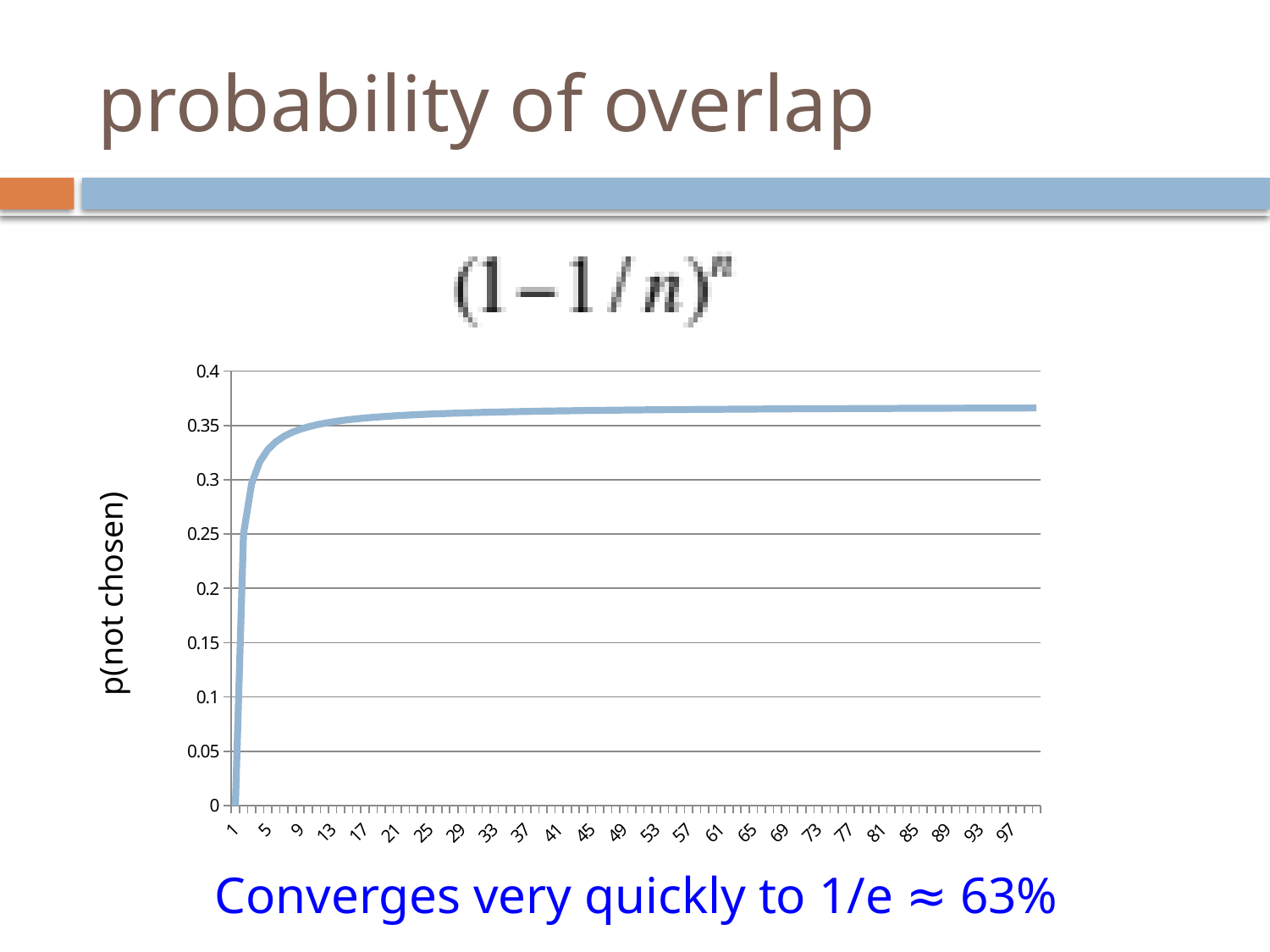
What is the label on the y axis of the chart? p(not chosen) What formula is shown above the chart? (1-1/n)^n What is the highest value shown on the y axis? 0.4 Which has the larger plotted value, n = 5 or n = 49? n = 49 How many tick labels are shown on the x axis? 25 Is the value for n = 97 greater or less than 0.35? greater Is the value for n = 9 greater or less than 0.3? greater What is the plotted value at n = 1? 0 Which has the larger plotted value, n = 1 or n = 97? n = 97 What kind of chart is shown on the slide? line chart Is the value for n = 97 greater or less than 0.4? less Do the plotted values rise or fall as n increases along the x axis? rise